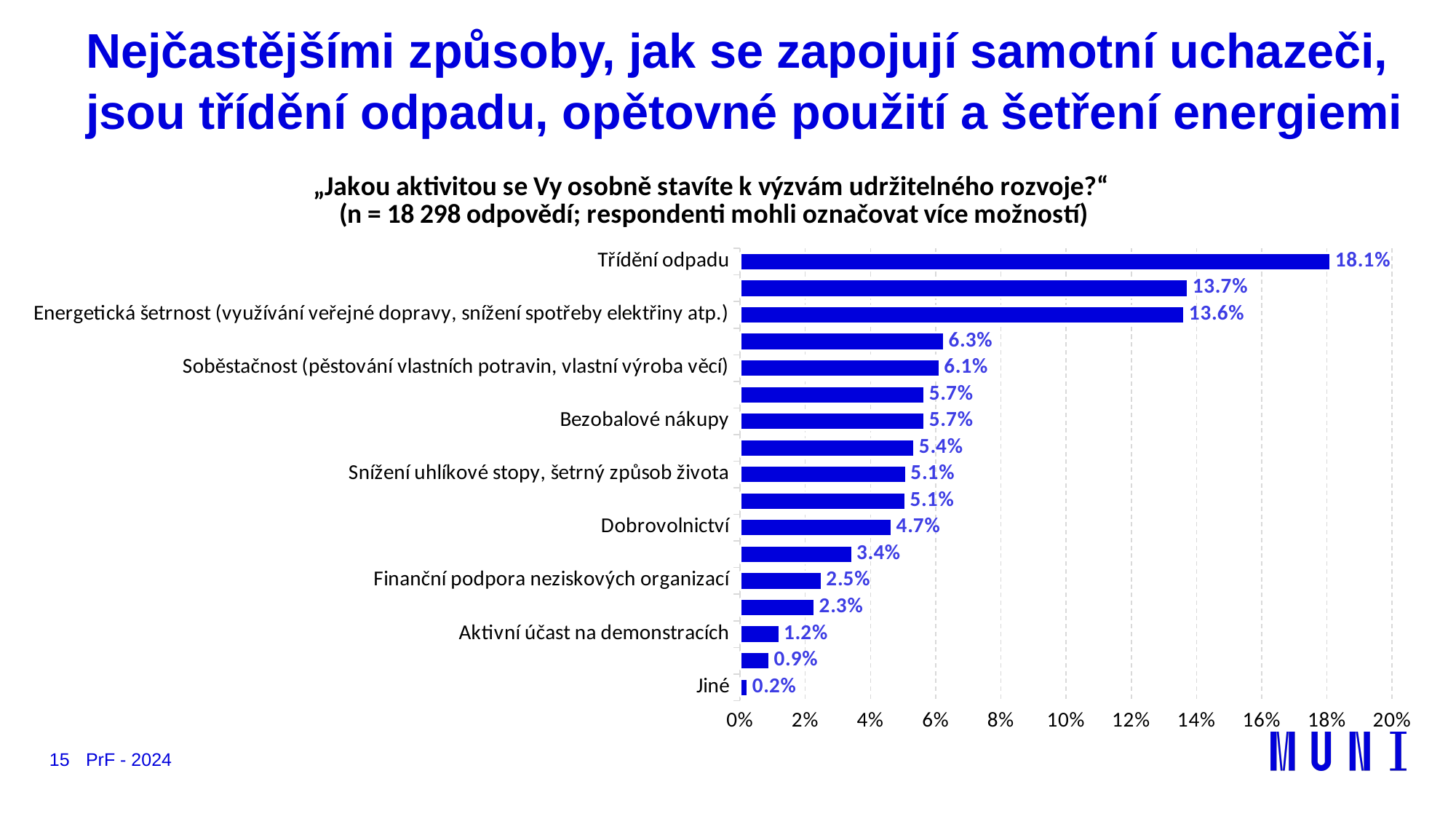
What is the value for Energetická šetrnost (využívání veřejné dopravy, snížení spotřeby elektřiny atp.)? 13.6% What is the value for Třídění odpadu? 18.1% Which category has the lowest value? Jiné How many bars are plotted in the chart? 17 What is the difference between the values for Třídění odpadu and Energetická šetrnost? 4.5 percentage points What is the value for Aktivní účast na demonstracích? 1.2% What is the value for Dobrovolnictví? 4.7% What kind of chart is shown on the slide? Bar chart Which category has the highest value? Třídění odpadu Which is larger, the value for Bezobalové nákupy or the value for Dobrovolnictví? Bezobalové nákupy Is the value for Finanční podpora neziskových organizací greater or less than 4%? less What is the sample size (n) stated in the chart title? 18 298 odpovědí